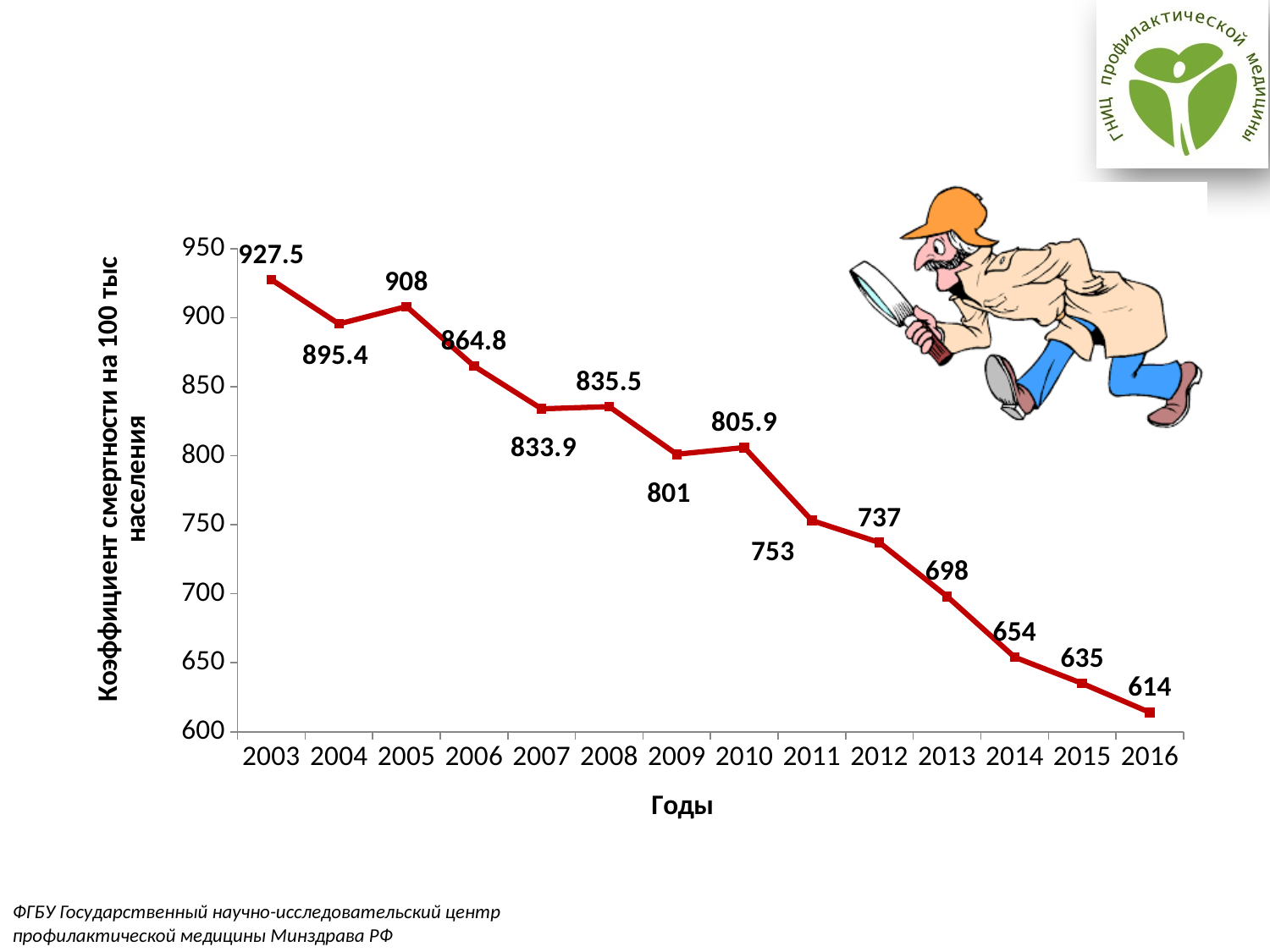
What is the difference between the values for 2003 and 2016? 313.5 Is the value for 2013 greater or less than 700? less Do the values generally rise or fall from 2003 to 2016? fall What is the difference between the values for 2011 and 2012? 16 What is the value plotted for 2016? 614 Which year has the highest value on the chart? 2003 What is the value plotted for 2010? 805.9 What is the mortality coefficient value for 2003? 927.5 Which year has the lowest value on the chart? 2016 How many years are plotted on the x axis? 14 Which is larger, the value for 2005 or the value for 2004? 2005 What kind of chart is shown on the slide? line chart